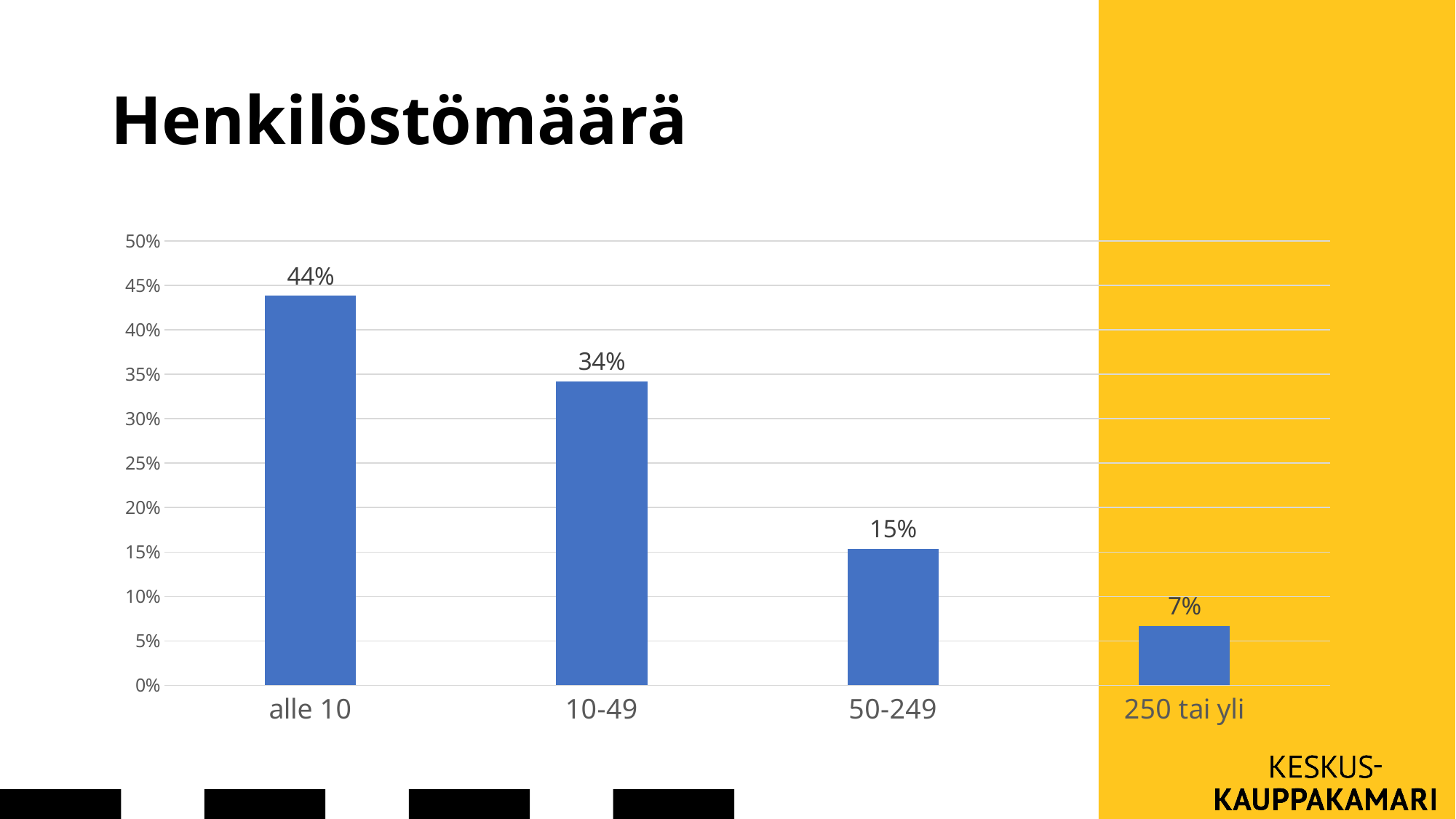
What is the value for the '50-249' category? 15% What is the value for the '10-49' category? 34% What is the value for the 'alle 10' category? 44% What is the difference between the values for 'alle 10' and '10-49'? 10% Which is larger, the value for '10-49' or the value for '50-249'? 10-49 What kind of chart is shown on the slide? bar chart What is the difference between the values for '50-249' and '250 tai yli'? 8% Which category has the lowest value? 250 tai yli Do the values rise or fall from left to right along the x axis? fall What is the value for the '250 tai yli' category? 7% How many categories are shown on the x axis? 4 Which category has the highest value? alle 10